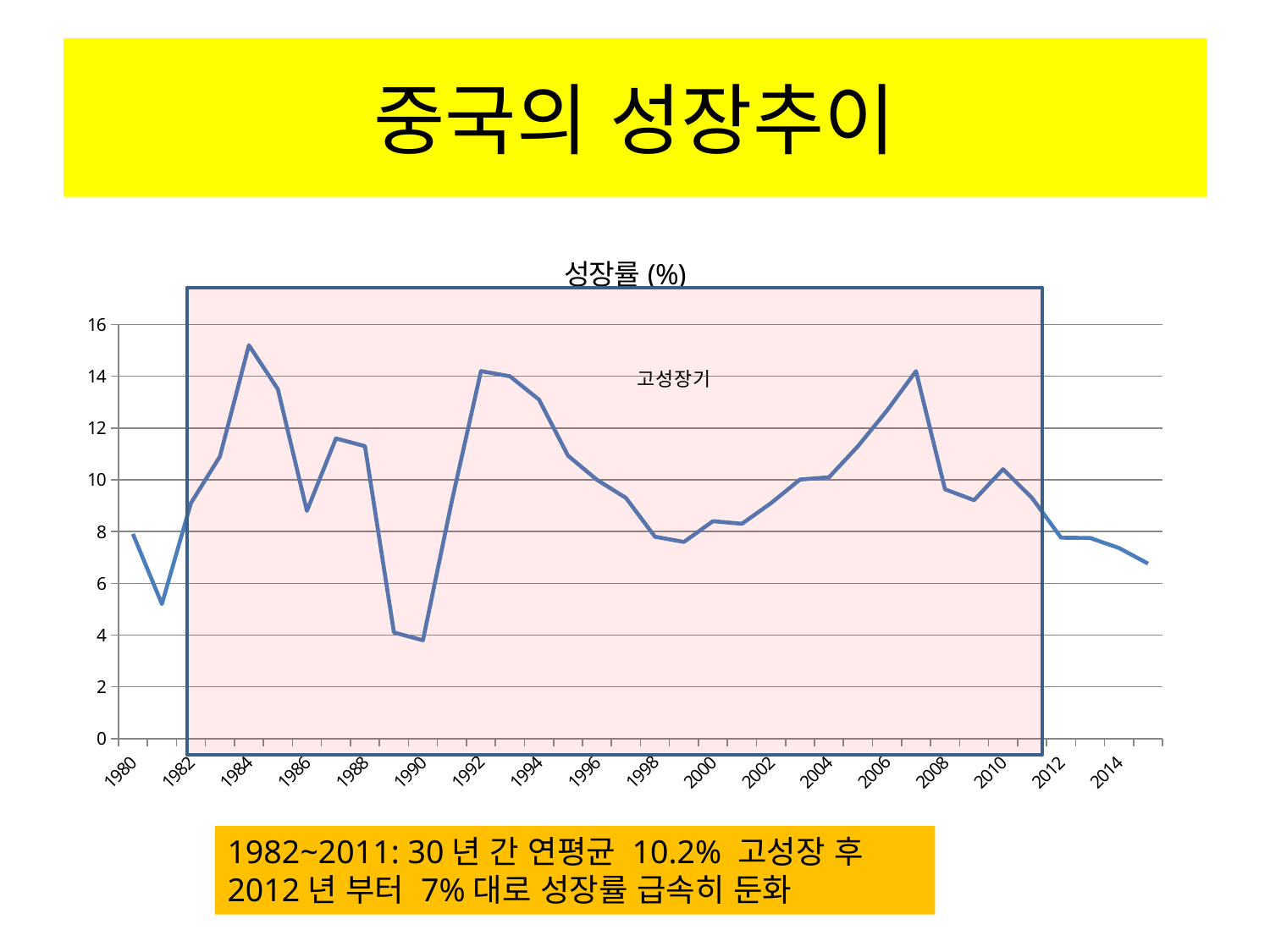
Which year has the lower growth rate, 1981 or 1990? 1990 In which year does the growth rate reach its highest point on the chart? 1984 Which year has the higher growth rate, 1984 or 2007? 1984 Is the growth rate for 1984 greater or less than 14? greater Is the growth rate for 1981 greater or less than 6? less Is the growth rate for 1990 greater or less than 6? less Does the growth rate rise or fall from 2012 to 2015? fall What is the title printed above the chart? 성장률 (%) What kind of chart is shown on the slide? line chart What label is written inside the shaded box on the chart? 고성장기